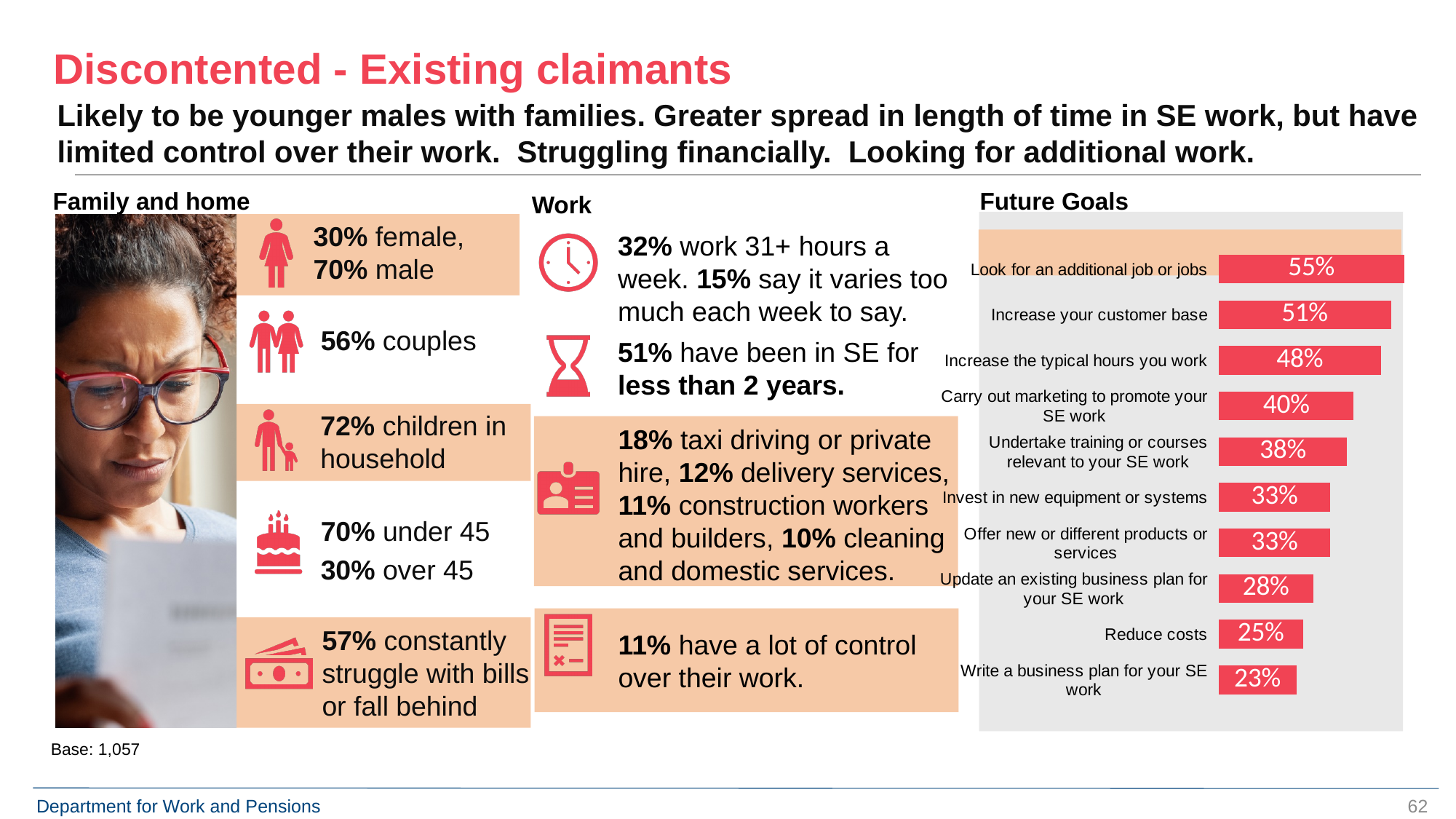
In the Future Goals chart, what percentage is shown for 'Look for an additional job or jobs'? 55% In the Future Goals chart, what is the value for 'Increase the typical hours you work'? 48% In the Future Goals chart, which goal has the highest percentage? Look for an additional job or jobs In the Future Goals chart, what is the difference between 'Increase your customer base' and 'Increase the typical hours you work'? 3% In the Future Goals chart, which is larger: 'Carry out marketing to promote your SE work' or 'Update an existing business plan for your SE work'? Carry out marketing to promote your SE work In the Future Goals chart, what percentage is shown for 'Undertake training or courses relevant to your SE work'? 38% In the Future Goals chart, what is the difference between 'Look for an additional job or jobs' and 'Write a business plan for your SE work'? 32% What type of chart is the Future Goals chart? Bar chart In the Future Goals chart, which two goals share the same value of 33%? Invest in new equipment or systems; Offer new or different products or services In the Future Goals chart, which goal has the lowest percentage? Write a business plan for your SE work In the Future Goals chart, how many goals are listed? 10 In the Future Goals chart, what is the value for 'Reduce costs'? 25%